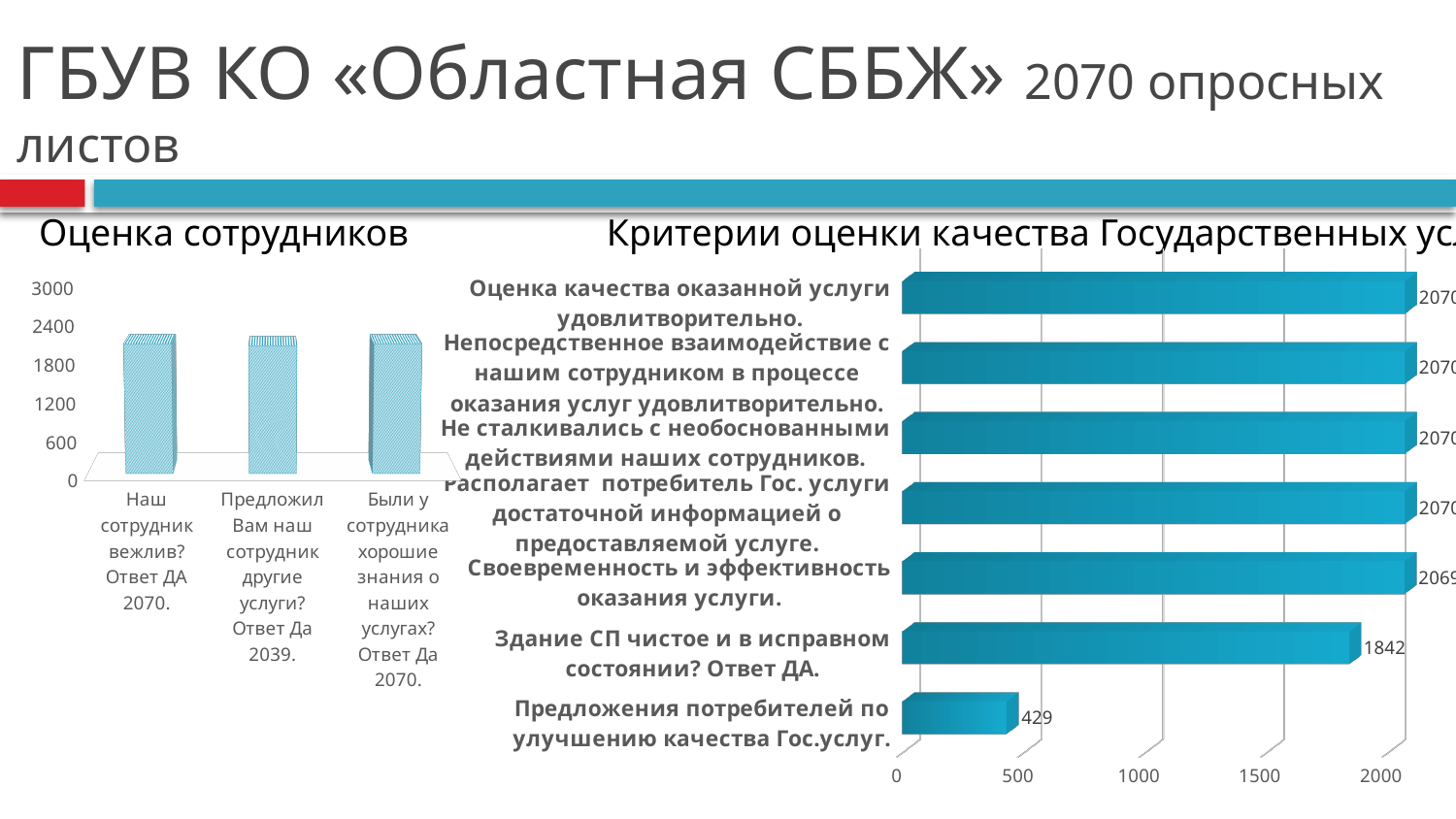
In the right chart, which category has the lowest value? Предложения потребителей по улучшению качества Гос.услуг. In the right chart, what is the value for 'Здание СП чистое и в исправном состоянии? Ответ ДА.'? 1842 How many bars are shown in the left 'Оценка сотрудников' chart? 3 In the right chart, what is the value for 'Своевременность и эффективность оказания услуги.'? 2069 In the right chart, what is the difference between the value for 'Здание СП чистое и в исправном состоянии? Ответ ДА.' and the value for 'Предложения потребителей по улучшению качества Гос.услуг.'? 1413 In the right chart, what is the difference between the value for 'Своевременность и эффективность оказания услуги.' and the value for 'Здание СП чистое и в исправном состоянии? Ответ ДА.'? 227 What kind of chart is the 'Критерии оценки качества Государственных услуг' chart on the right? bar chart In the right chart, which is larger: the value for 'Здание СП чистое и в исправном состоянии? Ответ ДА.' or the value for 'Предложения потребителей по улучшению качества Гос.услуг.'? Здание СП чистое и в исправном состоянии? Ответ ДА. What kind of chart is the 'Оценка сотрудников' chart on the left? bar chart How many categories are shown in the right chart? 7 In the right chart, what is the value for 'Оценка качества оказанной услуги удовлитворительно.'? 2070 In the right chart, what is the value for 'Предложения потребителей по улучшению качества Гос.услуг.'? 429